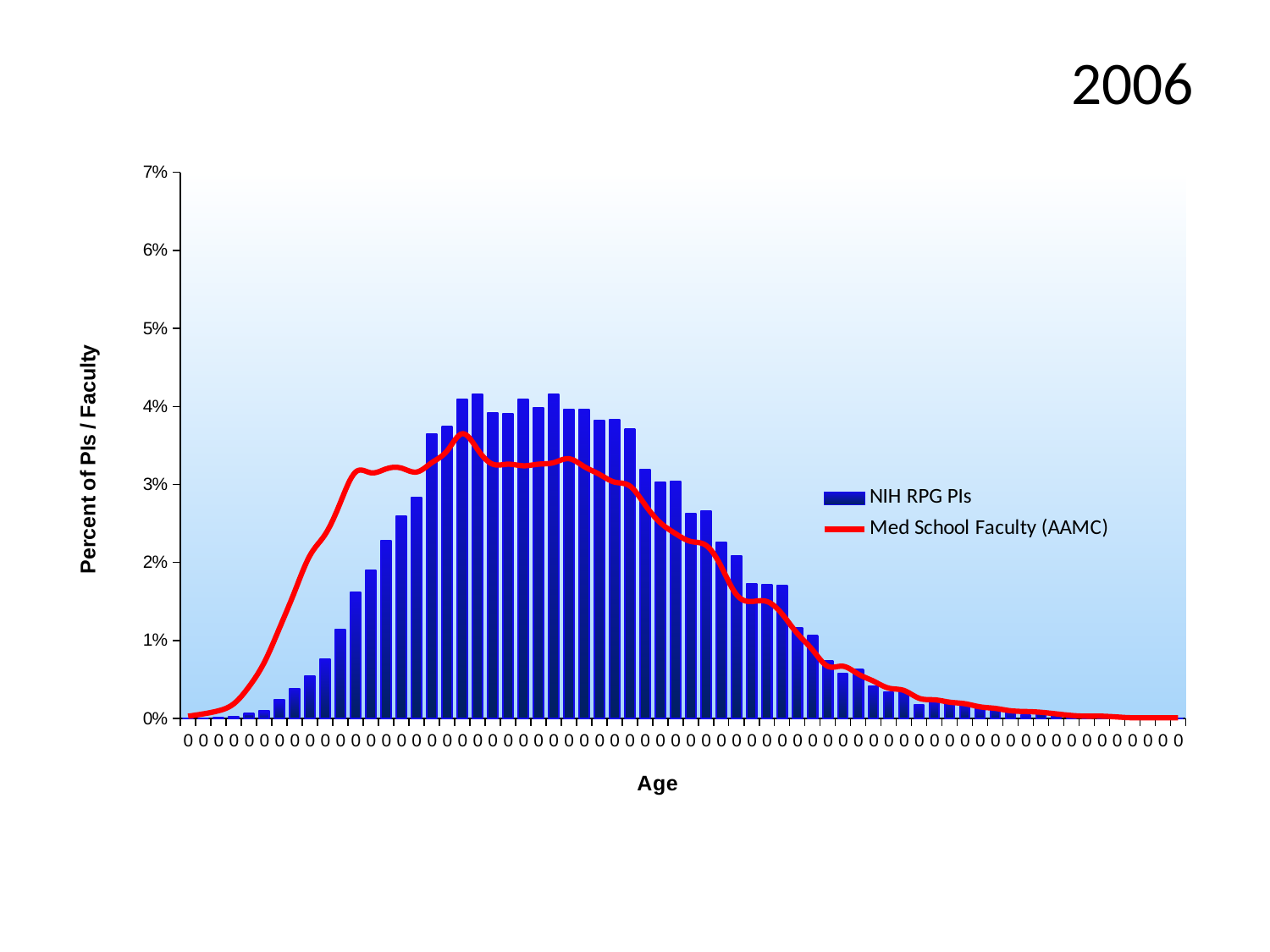
Which series is drawn as bars, NIH RPG PIs or Med School Faculty (AAMC)? NIH RPG PIs Is the peak of the Med School Faculty (AAMC) line greater or less than 3%? greater What kind of chart is shown on the slide? bar chart with a line overlay Do the NIH RPG PIs bars rise or fall along the right-hand half of the x axis? fall How many series does the chart legend list? 2 What is the title of the y axis? Percent of PIs / Faculty Which series reaches a higher peak value, NIH RPG PIs or Med School Faculty (AAMC)? NIH RPG PIs Is the tallest NIH RPG PIs bar greater or less than 3%? greater What is the highest value shown on the y axis? 7% Is the peak of the Med School Faculty (AAMC) line greater or less than 4%? less